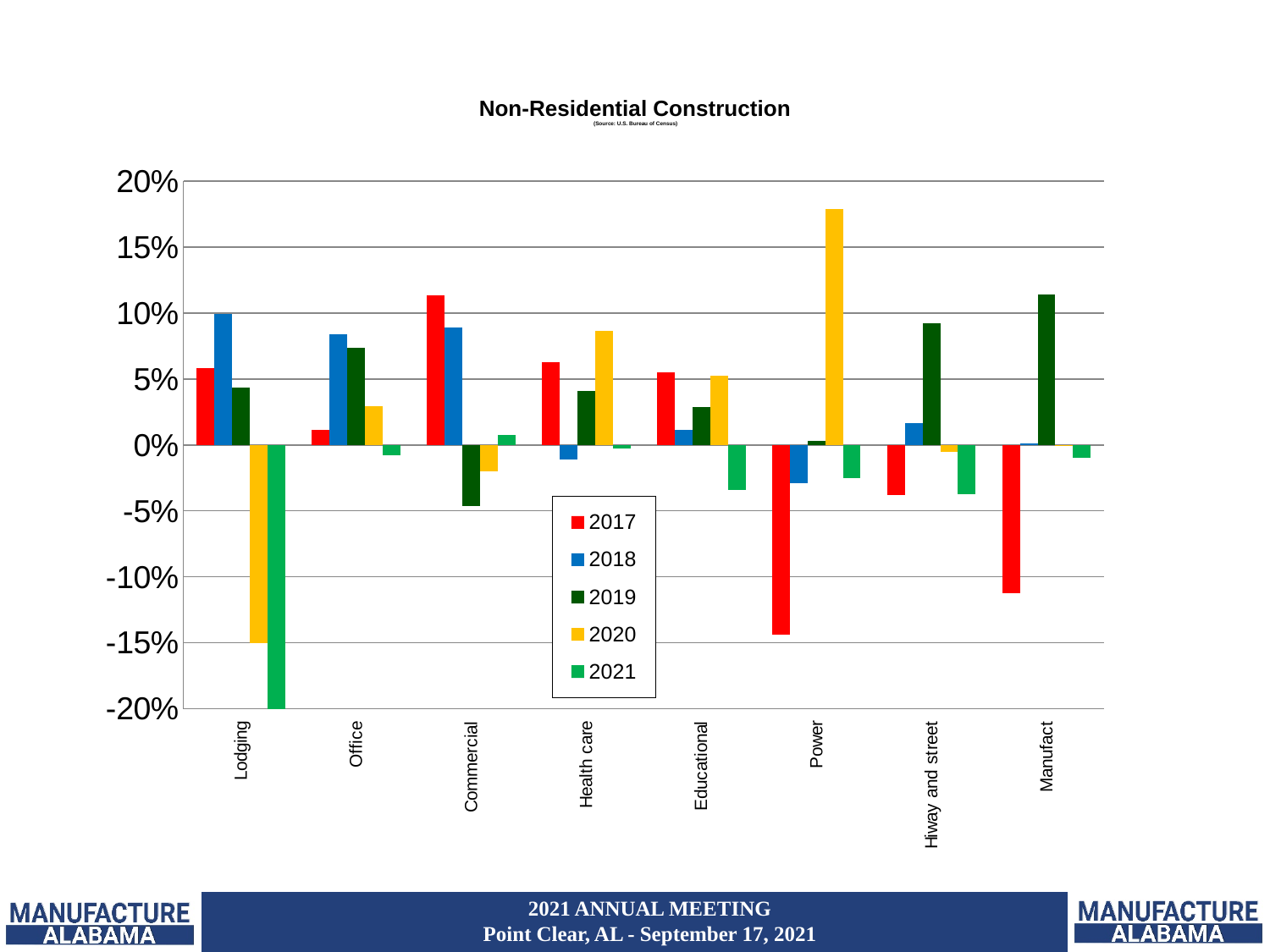
What is the title of the chart? Non-Residential Construction Which category has the lowest value for 2017? Power Which is larger, the 2019 value for Hiway and street or the 2019 value for Manufact? Manufact Is the 2020 value for Power greater or less than 15%? greater What kind of chart is shown on the slide? bar chart Which category has the lowest value for 2021? Lodging Which is larger, the 2017 value for Commercial or the 2017 value for Office? Commercial Is the 2020 value for Lodging greater or less than -10%? less Which category has the highest value for 2020? Power How many categories are shown on the x axis of the chart? 8 Which category has the highest value for 2017? Commercial How many series does the legend list? 5